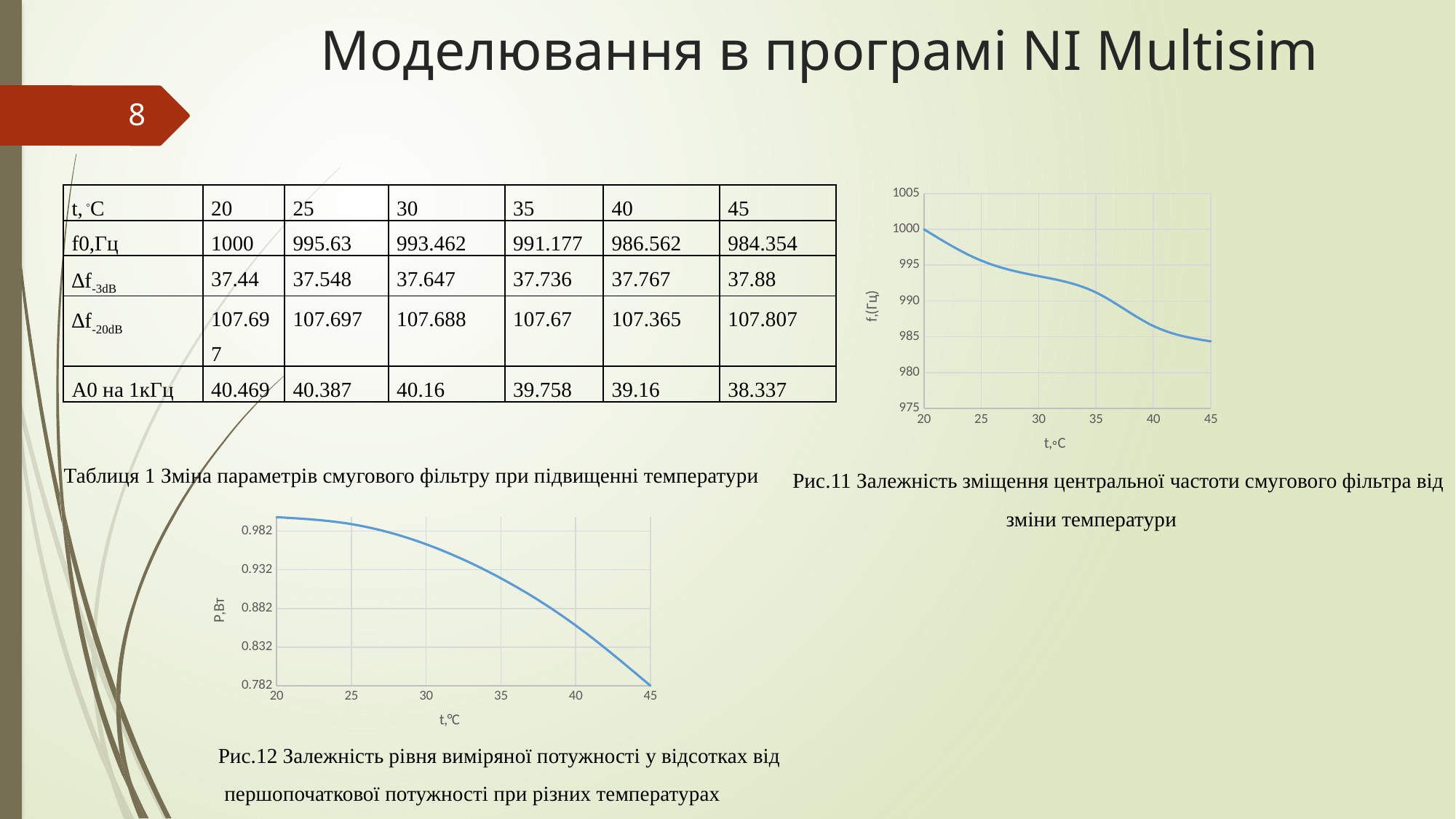
In Рис.11, is the value at t = 30 greater or less than 990? greater In Рис.12, do the values rise or fall as temperature increases along the x axis? fall In Рис.11, which is larger: the value at t = 20 or the value at t = 45? t = 20 In Рис.11, do the values rise or fall as temperature increases along the x axis? fall What is the y-axis label of Рис.12? P,Вт In Рис.12, is the value at t = 30 greater or less than 0.932? greater What kind of chart is Рис.12 (the chart at the bottom left)? line chart How many temperature ticks are shown on the x axis of Рис.12? 6 What kind of chart is Рис.11 (the chart on the right)? line chart In Рис.11, is the value at t = 45 greater or less than 985? less In Рис.11, what is the value of f at t = 20 °C? 1000